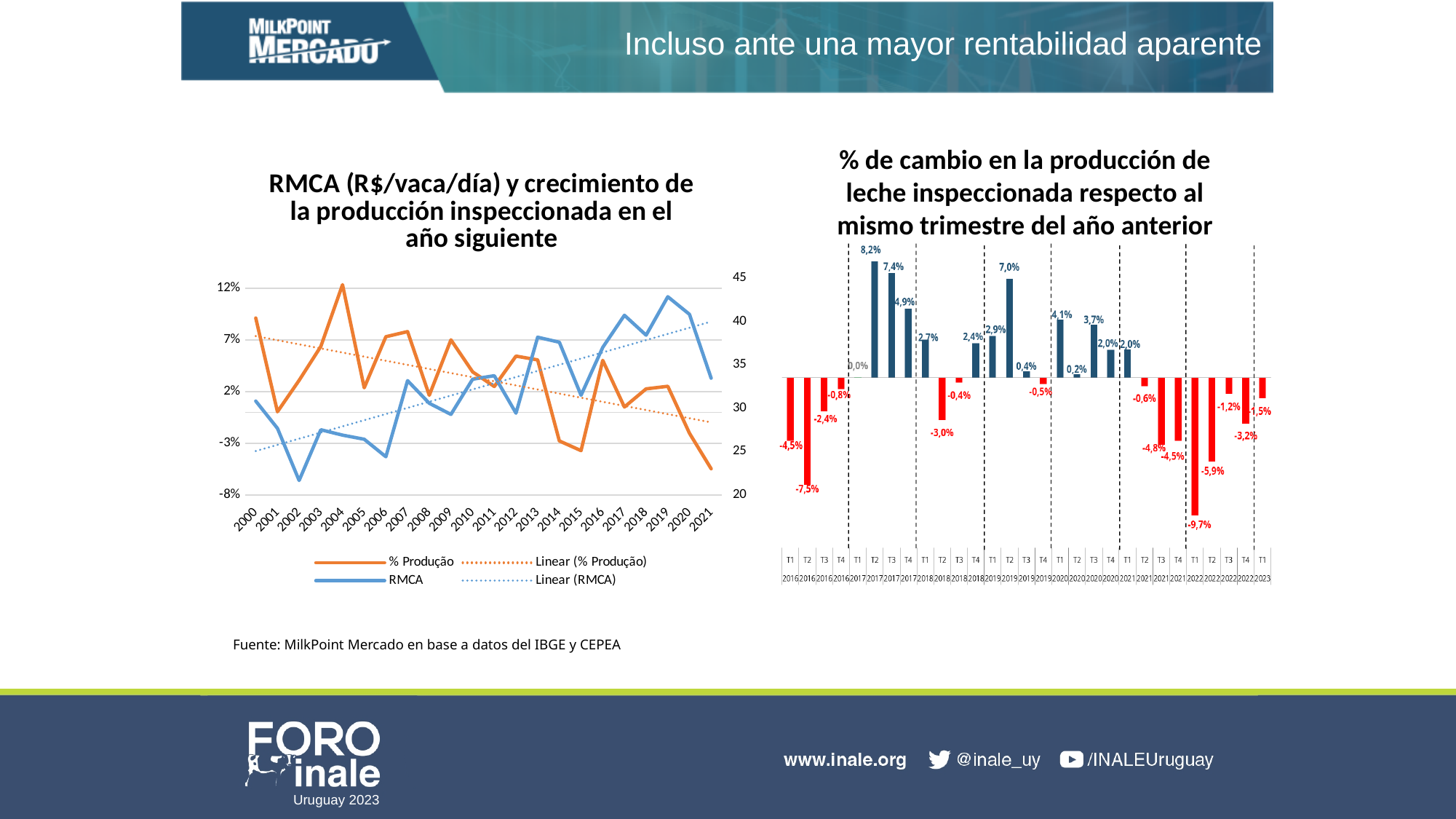
How many bars are plotted in the chart '% de cambio en la producción de leche inspeccionada respecto al mismo trimestre del año anterior'? 29 In the chart '% de cambio en la producción de leche inspeccionada respecto al mismo trimestre del año anterior', what is the value for T2 2017? 8,2% In the chart '% de cambio en la producción de leche inspeccionada respecto al mismo trimestre del año anterior', what is the value for T1 2023? -1,5% In the chart '% de cambio en la producción de leche inspeccionada respecto al mismo trimestre del año anterior', what is the difference between the values for T2 2017 and T3 2017? 0,8% What kind of chart is the chart on the left, 'RMCA (R$/vaca/día) y crecimiento de la producción inspeccionada en el año siguiente'? Line chart In the chart '% de cambio en la producción de leche inspeccionada respecto al mismo trimestre del año anterior', which quarter has the lowest value? T1 2022 How many entries does the legend list in the chart 'RMCA (R$/vaca/día) y crecimiento de la producción inspeccionada en el año siguiente'? 4 In the chart '% de cambio en la producción de leche inspeccionada respecto al mismo trimestre del año anterior', which is larger: the value for T2 2019 or the value for T1 2020? T2 2019 In the chart 'RMCA (R$/vaca/día) y crecimiento de la producción inspeccionada en el año siguiente', is the RMCA value for 2002 greater or less than 25? less What kind of chart is the chart on the right, '% de cambio en la producción de leche inspeccionada respecto al mismo trimestre del año anterior'? Bar chart In the chart '% de cambio en la producción de leche inspeccionada respecto al mismo trimestre del año anterior', what is the value for T1 2022? -9,7% In the chart '% de cambio en la producción de leche inspeccionada respecto al mismo trimestre del año anterior', which quarter has the highest value? T2 2017